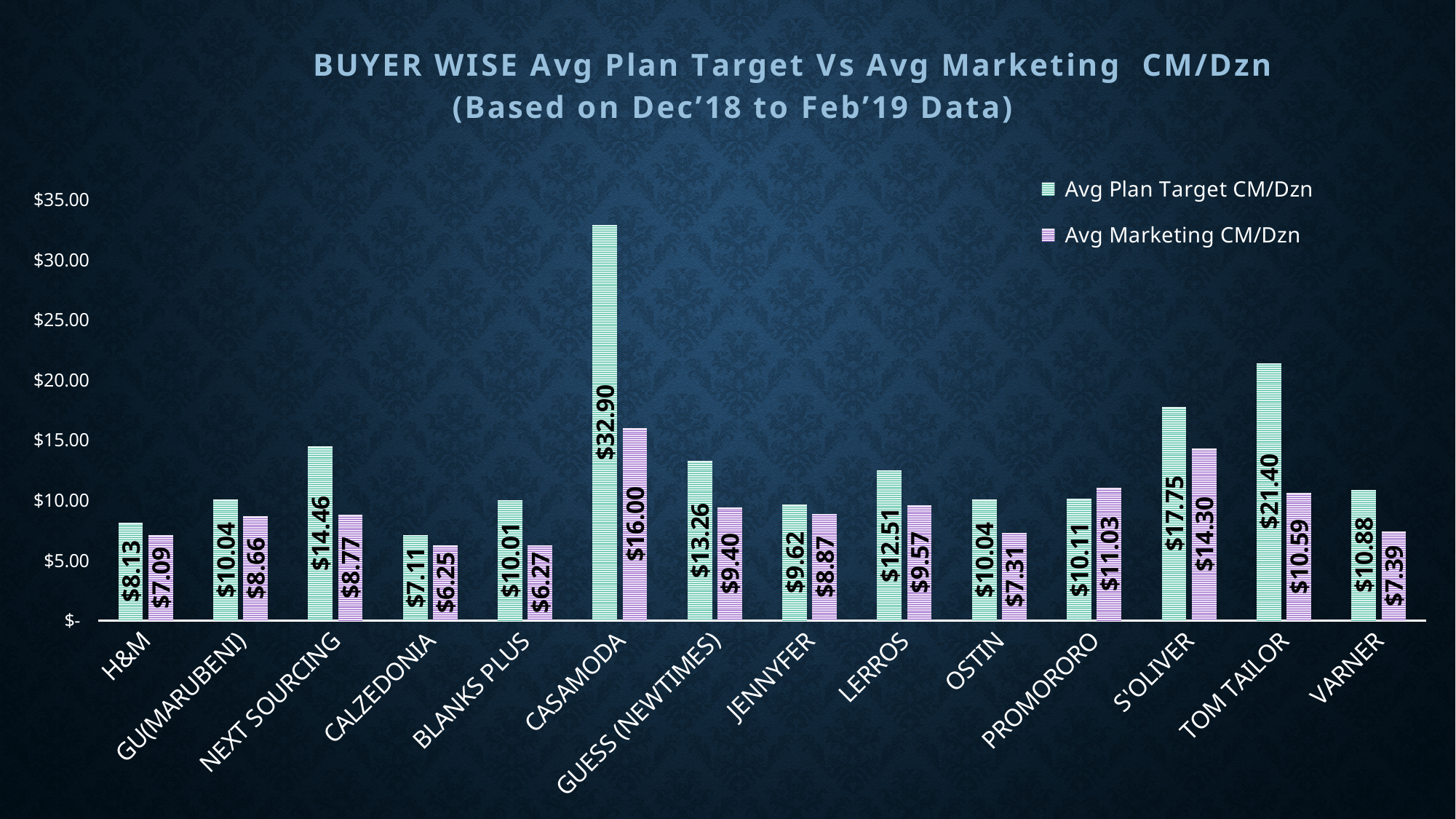
How many series does the legend list? 2 What is the difference between the Avg Plan Target CM/Dzn and the Avg Marketing CM/Dzn for S'OLIVER? $3.45 Which is larger for PROMORORO: the Avg Plan Target CM/Dzn or the Avg Marketing CM/Dzn? Avg Marketing CM/Dzn What is the Avg Marketing CM/Dzn for TOM TAILOR? $10.59 Which buyer has the highest Avg Plan Target CM/Dzn? CASAMODA Is the Avg Plan Target CM/Dzn for TOM TAILOR greater or less than $20.00? greater Which buyer has the lowest Avg Marketing CM/Dzn? CALZEDONIA What period of data is the chart based on, according to the title? Dec'18 to Feb'19 What kind of chart is shown on the slide? Bar chart What is the Avg Marketing CM/Dzn for PROMORORO? $11.03 How many buyers are shown on the x axis? 14 What is the Avg Plan Target CM/Dzn for CASAMODA? $32.90